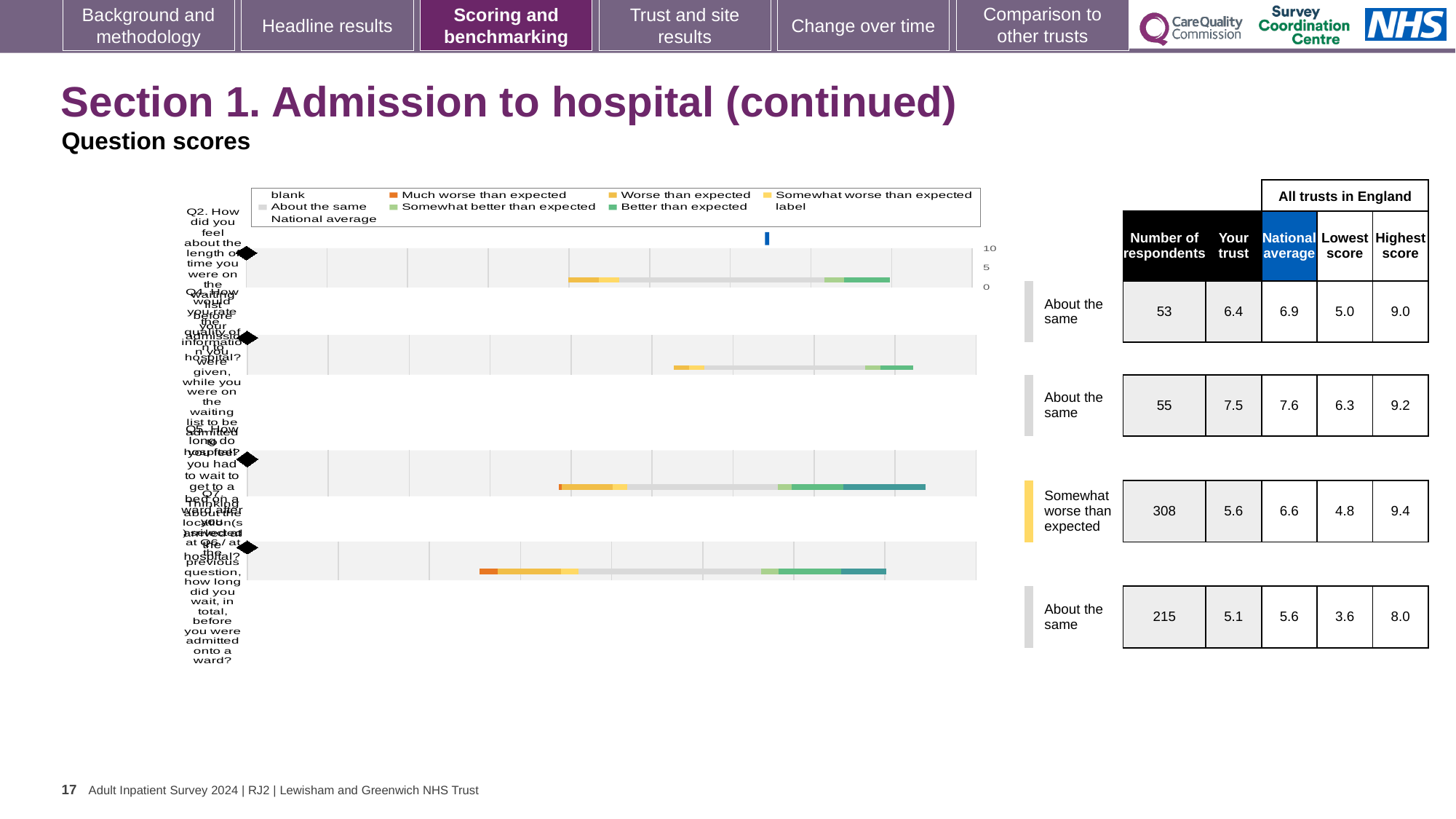
What is the difference between the national average and the 'Your trust' score for Q5 (the third row)? 1.0 What is the lowest score among all trusts in England for Q7 (the fourth row)? 3.6 Which benchmark category is shown for Q5 (the third row)? Somewhat worse than expected Which question has the lowest 'Your trust' score? Q7 How many questions (categories) are plotted in the chart? 4 What is the 'Your trust' score for Q2 (the first row)? 6.4 How many respondents answered Q5 (the third row)? 308 Which has the higher 'Your trust' score, Q2 or Q4? Q4 What is the highest score among all trusts in England for Q4 (the second row)? 9.2 Which question has the highest number of respondents? Q5 What kind of chart is shown on the slide? bar chart What is the national average for Q4 (the second row)? 7.6